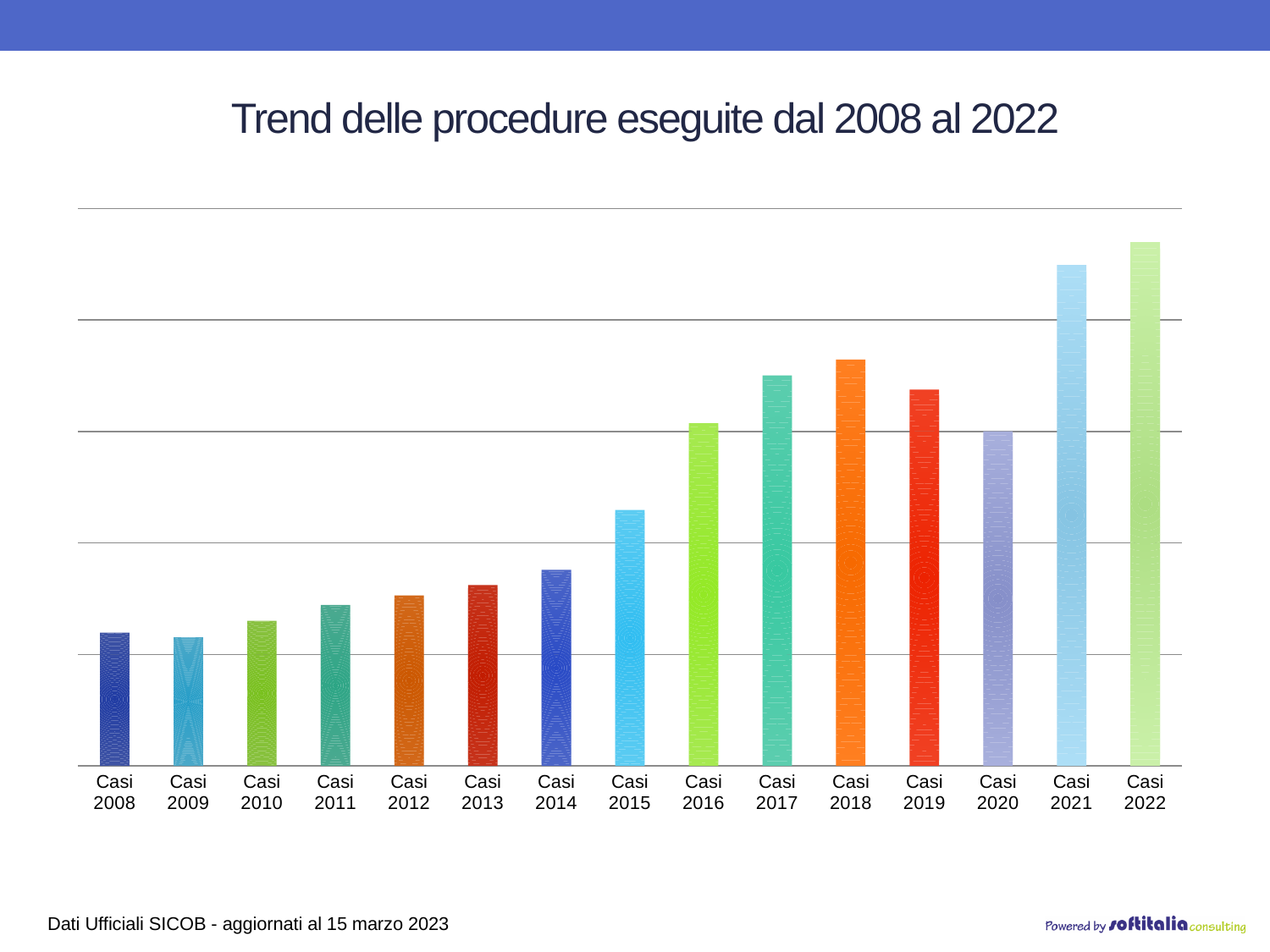
Which bar is taller, Casi 2012 or Casi 2014? Casi 2014 What data source is cited at the bottom of the slide? Dati Ufficiali SICOB - aggiornati al 15 marzo 2023 Which bar is taller, Casi 2017 or Casi 2018? Casi 2018 Which category has the highest bar? Casi 2022 How many categories (years) are plotted on the chart? 15 What kind of chart is shown on the slide? Bar chart Do the values rise or fall from Casi 2018 to Casi 2020? Fall What is the title of the chart? Trend delle procedure eseguite dal 2008 al 2022 Do the values generally rise or fall from Casi 2008 to Casi 2022? Rise Which bar is taller, Casi 2015 or Casi 2016? Casi 2016